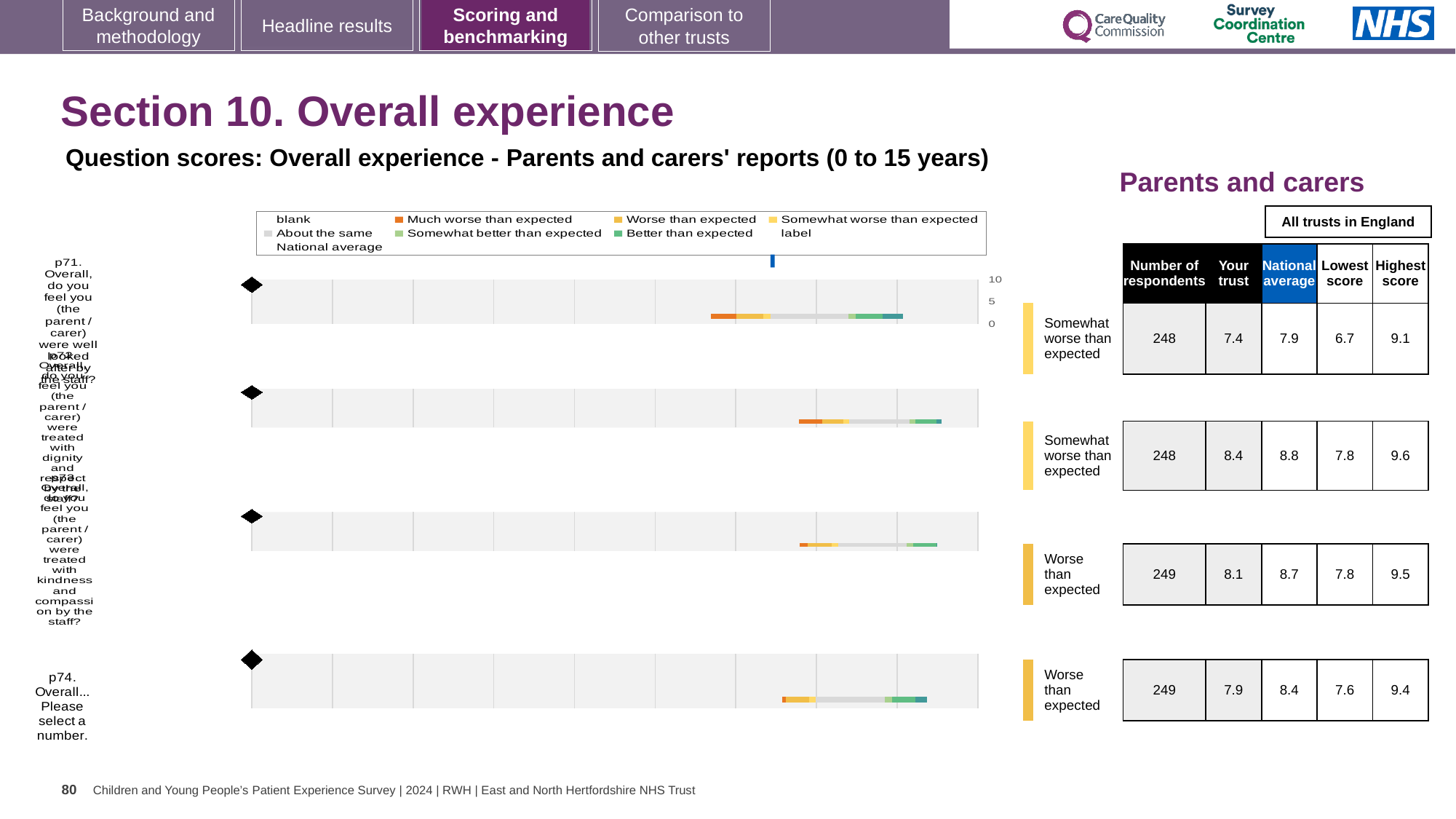
For p71, is the 'Your trust' score higher or lower than the national average? Lower What colour does the legend use for 'Much worse than expected'? Orange Which benchmark category is shown for p74? Worse than expected What is the difference between the national average and the 'Your trust' score for p71? 0.5 What kind of chart is used to show the question scores on this slide? Bar chart How many question rows (bars) are plotted in the chart? 4 Which row has the highest 'Your trust' score? The second row from the top (8.4) Which row has the lowest 'Your trust' score? p71 (7.4) What is the national average score for p71? 7.9 What is the highest score across all trusts in England for p74? 9.4 What is the 'Your trust' score for p71 (Overall, do you feel you were well looked after by the staff?)? 7.4 How many respondents are listed for p74 (Overall... Please select a number)? 249